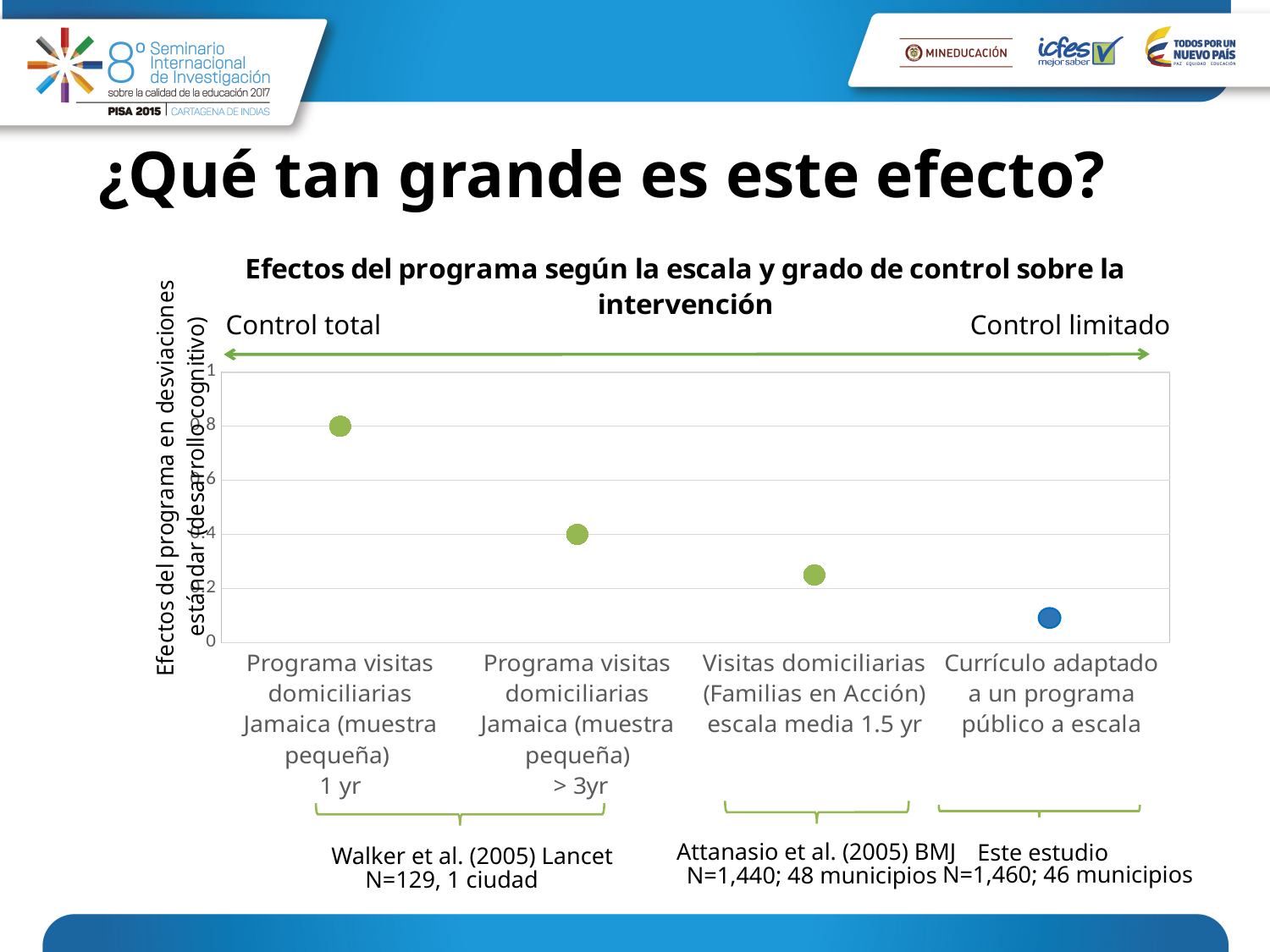
What is the program effect for 'Programa visitas domiciliarias Jamaica (muestra pequeña) 1 yr'? 0.8 How many categories are plotted on the x axis of the chart? 4 Do the plotted values rise or fall from left to right along the x axis? Fall What is the title of the chart? Efectos del programa según la escala y grado de control sobre la intervención Is the value for 'Currículo adaptado a un programa público a escala' greater or less than 0.2? less Is the value for 'Visitas domiciliarias (Familias en Acción) escala media 1.5 yr' greater or less than 0.2? greater What kind of chart is shown on the slide? Scatter (dot) chart What is the program effect for 'Programa visitas domiciliarias Jamaica (muestra pequeña) > 3yr'? 0.4 Which category has the highest program effect? Programa visitas domiciliarias Jamaica (muestra pequeña) 1 yr Is the value for 'Visitas domiciliarias (Familias en Acción) escala media 1.5 yr' greater or less than 0.4? less Which is larger: the effect for the Jamaica program at 1 yr or the Jamaica program at > 3yr? Jamaica program at 1 yr Which category has the lowest program effect? Currículo adaptado a un programa público a escala